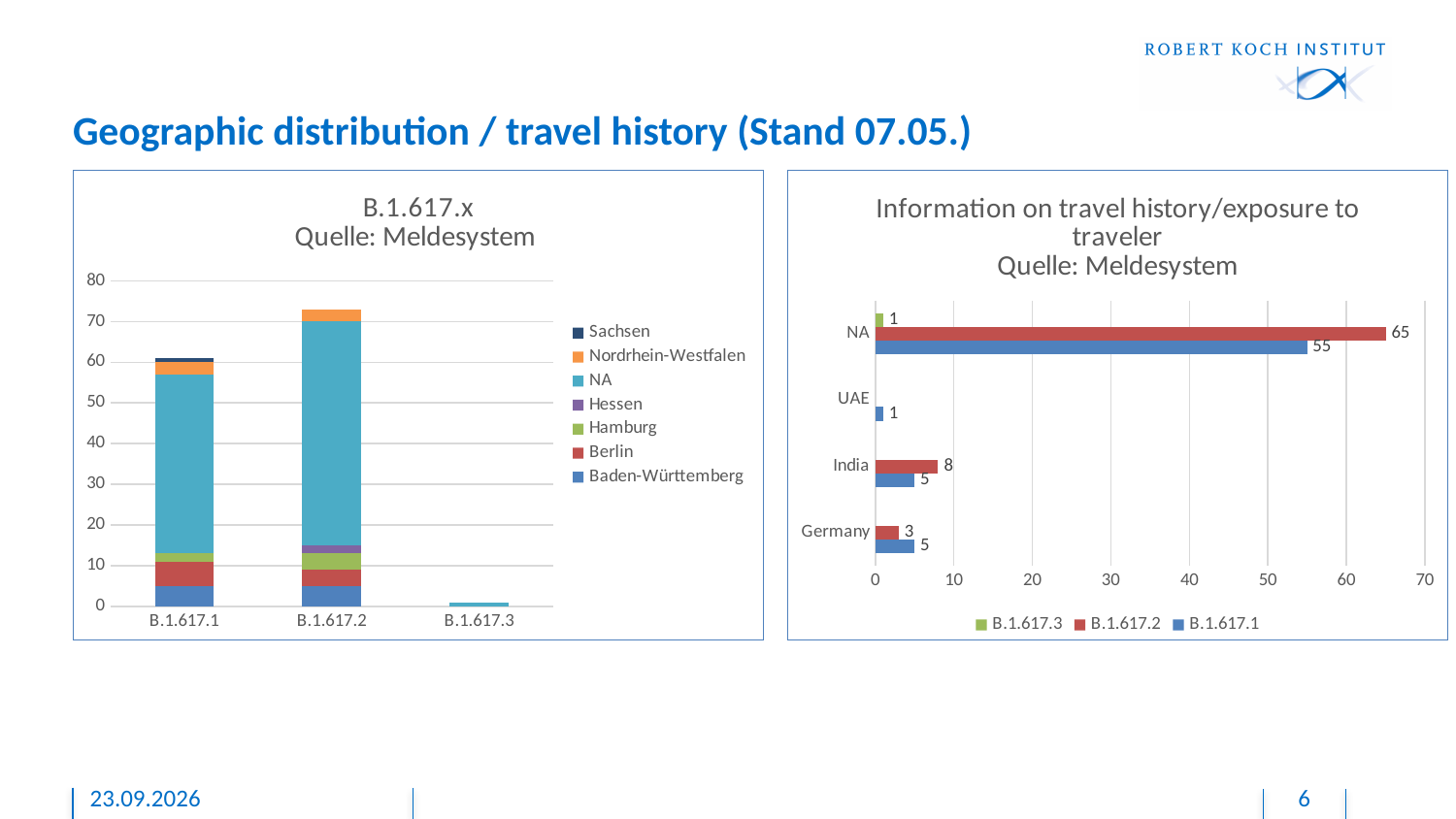
In the chart titled 'Information on travel history/exposure to traveler', which category has the highest B.1.617.2 value? NA In the chart titled 'Information on travel history/exposure to traveler', what is the difference between the B.1.617.2 and B.1.617.1 values for NA? 10 In the chart titled 'Information on travel history/exposure to traveler', what is the value for B.1.617.1 in the UAE category? 1 In the chart titled 'B.1.617.x Quelle: Meldesystem', is the total height of the B.1.617.2 bar greater or less than 70? greater In the chart titled 'Information on travel history/exposure to traveler', what is the value for B.1.617.2 in the NA category? 65 How many categories are shown on the y axis of the chart titled 'Information on travel history/exposure to traveler'? 4 How many series does the legend of the chart titled 'Information on travel history/exposure to traveler' list? 3 In the chart titled 'Information on travel history/exposure to traveler', which is larger for Germany: B.1.617.1 or B.1.617.2? B.1.617.1 What kind of chart is the chart titled 'B.1.617.x Quelle: Meldesystem'? stacked bar chart In the chart titled 'Information on travel history/exposure to traveler', what is the value for B.1.617.1 in the India category? 5 In the chart titled 'B.1.617.x Quelle: Meldesystem', which category has the tallest stacked bar? B.1.617.2 How many series does the legend of the chart titled 'B.1.617.x Quelle: Meldesystem' list? 7